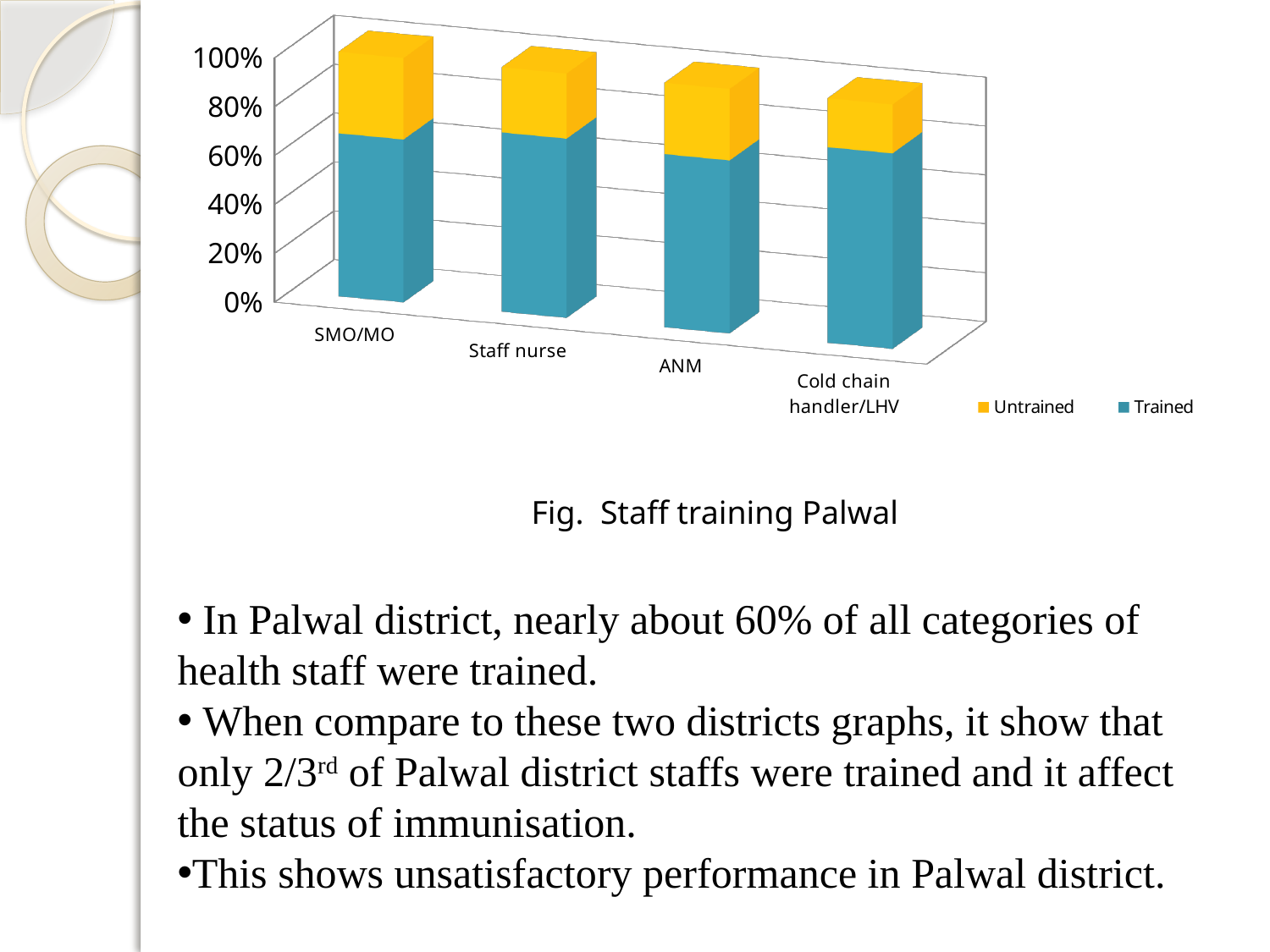
What are the two series listed in the chart legend? Untrained and Trained For Cold chain handler/LHV, which is larger: the Trained portion or the Untrained portion? Trained Which category is listed last on the x axis of the chart? Cold chain handler/LHV How many staff categories are shown on the x axis of the chart? 4 Is the Trained value for Staff nurse greater or less than 20%? greater Is the Trained value for ANM greater or less than 40%? greater What is the caption given for the chart? Fig. Staff training Palwal How many series does the chart legend list? 2 For SMO/MO, which is larger: the Trained portion or the Untrained portion? Trained Is the Trained value for SMO/MO greater or less than 40%? greater What kind of chart is shown on the slide? Stacked bar chart